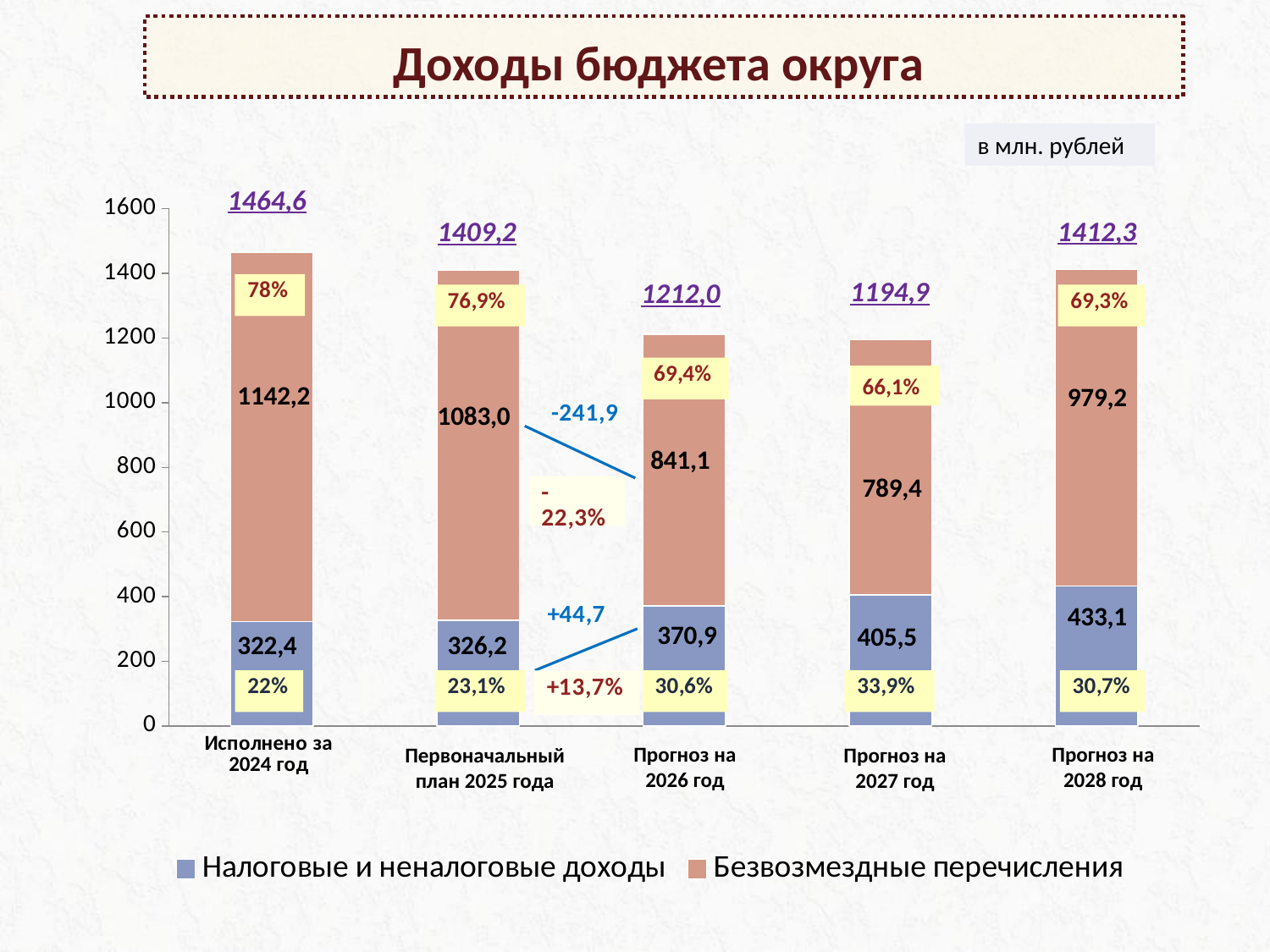
What kind of chart is shown on the slide? Stacked bar chart Do the values of Налоговые и неналоговые доходы rise or fall from left to right along the x axis? Rise What percentage label is shown for Безвозмездные перечисления in Исполнено за 2024 год? 78% Which is larger: Налоговые и неналоговые доходы for Прогноз на 2027 год or for Прогноз на 2028 год? Прогноз на 2028 год Which category has the lowest total bar? Прогноз на 2027 год What is the value of Налоговые и неналоговые доходы for Прогноз на 2026 год? 370,9 What is the value of Безвозмездные перечисления for Исполнено за 2024 год? 1142,2 How many series does the legend list? 2 How many categories are shown on the x axis? 5 Which category has the highest total bar? Исполнено за 2024 год What is the total of the stacked bar for Прогноз на 2028 год? 1412,3 What is the difference in Безвозмездные перечисления between Первоначальный план 2025 года and Прогноз на 2026 год? 241,9